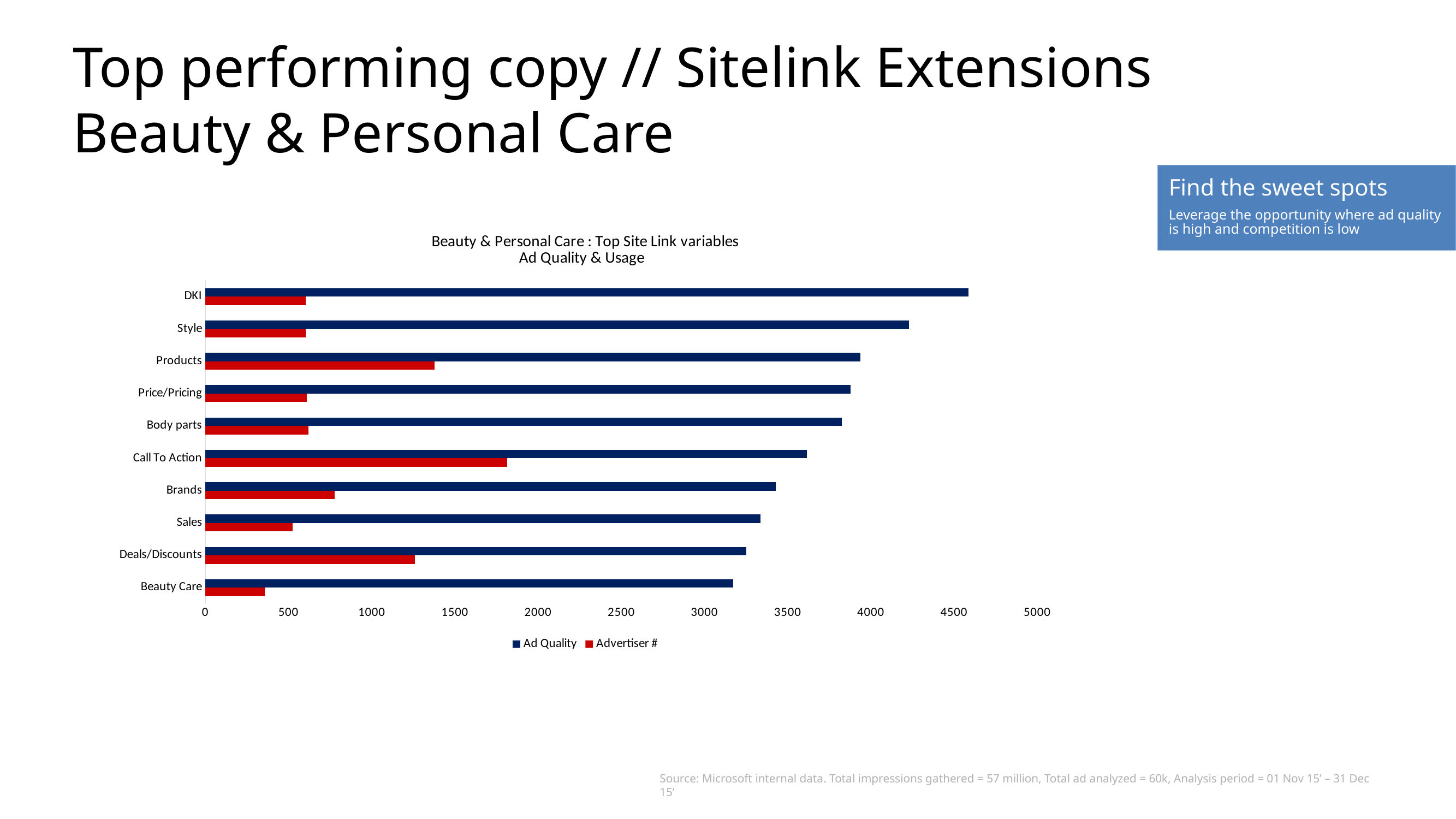
Which has a larger Advertiser # value, Deals/Discounts or Brands? Deals/Discounts Which category has the lowest Advertiser # value? Beauty Care Which category has the lowest Ad Quality value? Beauty Care What kind of chart is shown on the slide? Bar chart Is the Ad Quality value for Beauty Care greater or less than 3500? less Which category has the highest Ad Quality value? DKI Which series is shown in red in the legend? Advertiser # Is the Advertiser # value for Products greater or less than 1000? greater How many series does the legend list? 2 Which category has the highest Advertiser # value? Call To Action How many categories are plotted on the chart? 10 Is the Ad Quality value for DKI greater or less than 4500? greater